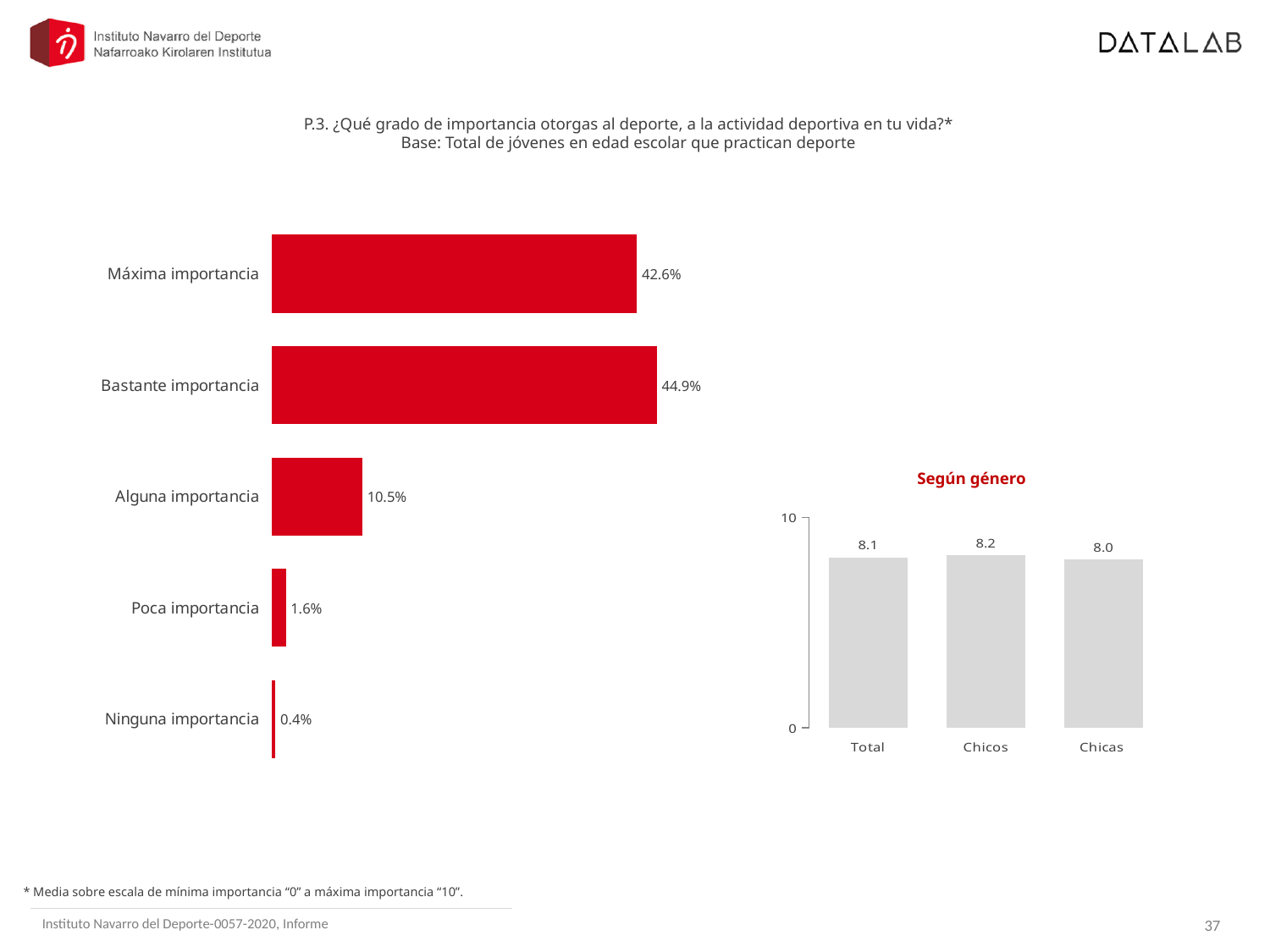
In the left chart, which category has the highest value? Bastante importancia In the left chart, what is the value for Bastante importancia? 44.9% In the left chart, which category has the lowest value? Ninguna importancia How many categories does the 'Según género' chart show? 3 In the 'Según género' chart, what is the value for Chicos? 8.2 What kind of chart is the left chart? Bar chart In the 'Según género' chart, what is the value for Chicas? 8.0 In the left chart, which is larger: Alguna importancia or Poca importancia? Alguna importancia In the left chart, what is the difference between Máxima importancia and Alguna importancia? 32.1% In the 'Según género' chart, what is the difference between Chicos and Chicas? 0.2 In the left chart, what is the value for Ninguna importancia? 0.4% How many categories does the left chart show? 5